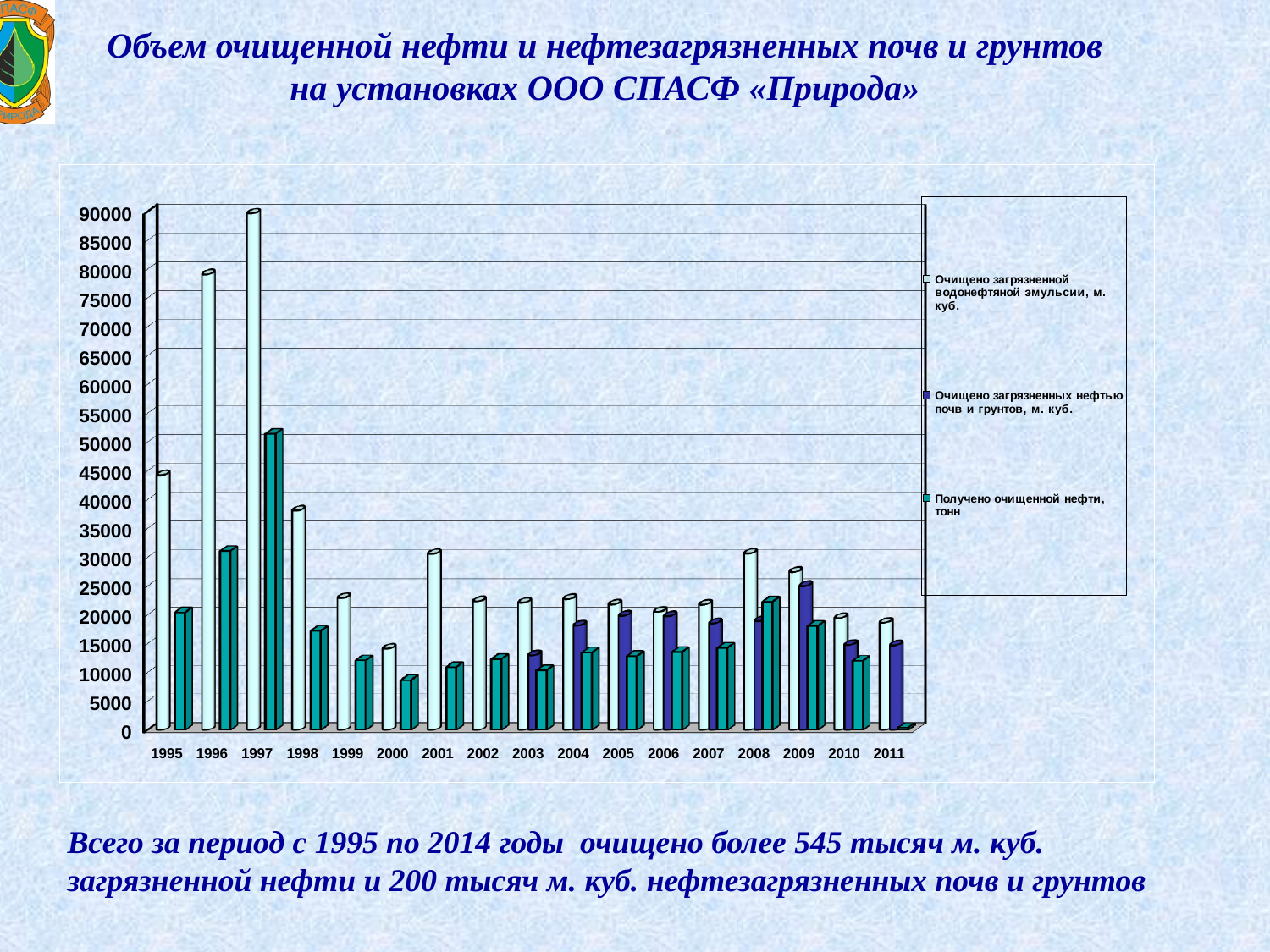
How many years are shown along the x axis of the chart? 17 Is the value for "Получено очищенной нефти, тонн" in 2000 greater or less than 10000? less Does the value for "Очищено загрязненной водонефтяной эмульсии, м. куб." rise or fall from 1995 to 1997? Rise Is the value for "Очищено загрязненной водонефтяной эмульсии, м. куб." in 1996 greater or less than 75000? greater What is the first series listed in the chart's legend? Очищено загрязненной водонефтяной эмульсии, м. куб. In which year is the value for "Получено очищенной нефти, тонн" the highest? 1997 Is the value for "Очищено загрязненных нефтью почв и грунтов, м. куб." in 2009 greater or less than 20000? greater What kind of chart is shown on the slide? Bar chart How many series does the chart's legend list? 3 In which year is the value for "Очищено загрязненной водонефтяной эмульсии, м. куб." the lowest? 2000 Which is larger in 1995: the value for "Очищено загрязненной водонефтяной эмульсии, м. куб." or the value for "Получено очищенной нефти, тонн"? Очищено загрязненной водонефтяной эмульсии, м. куб. In which year is the value for "Очищено загрязненной водонефтяной эмульсии, м. куб." the highest? 1997